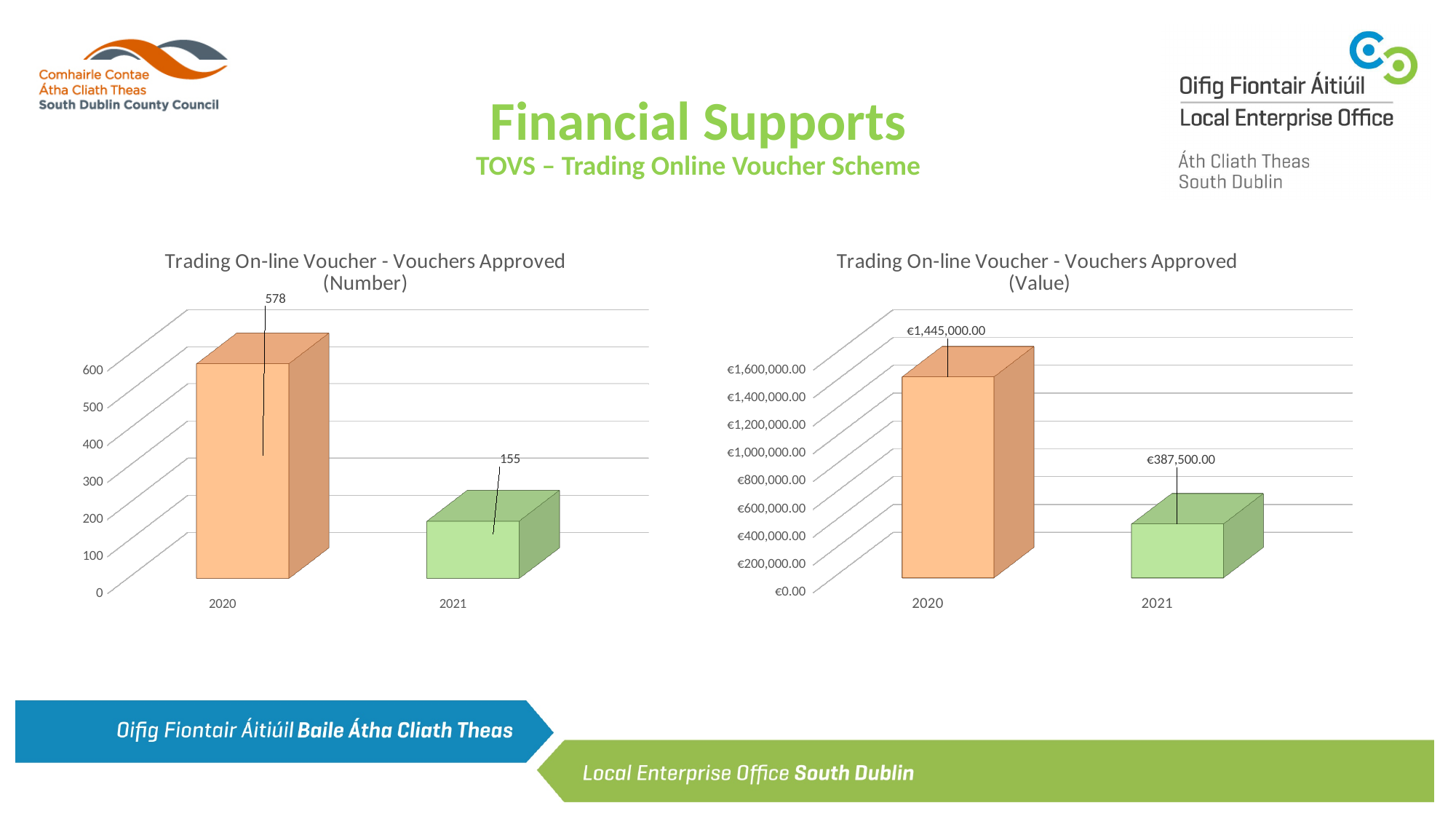
In the 'Trading On-line Voucher - Vouchers Approved (Value)' chart, what is the value for 2020? €1,445,000.00 In the 'Trading On-line Voucher - Vouchers Approved (Number)' chart, what is the value for 2021? 155 In the 'Trading On-line Voucher - Vouchers Approved (Number)' chart, which year has the highest value? 2020 In the 'Trading On-line Voucher - Vouchers Approved (Value)' chart, what is the value for 2021? €387,500.00 In the 'Trading On-line Voucher - Vouchers Approved (Value)' chart, is the value for 2021 greater or less than €400,000.00? less What kind of chart is the 'Trading On-line Voucher - Vouchers Approved (Value)' chart? Bar chart How many categories are shown on the x axis of the 'Trading On-line Voucher - Vouchers Approved (Number)' chart? 2 In the 'Trading On-line Voucher - Vouchers Approved (Number)' chart, what is the value for 2020? 578 In the 'Trading On-line Voucher - Vouchers Approved (Value)' chart, which year has the lowest value? 2021 In the 'Trading On-line Voucher - Vouchers Approved (Value)' chart, what is the difference between the 2020 and 2021 values? €1,057,500.00 In the 'Trading On-line Voucher - Vouchers Approved (Number)' chart, do the values rise or fall from 2020 to 2021? Fall In the 'Trading On-line Voucher - Vouchers Approved (Number)' chart, what is the difference between the 2020 and 2021 values? 423